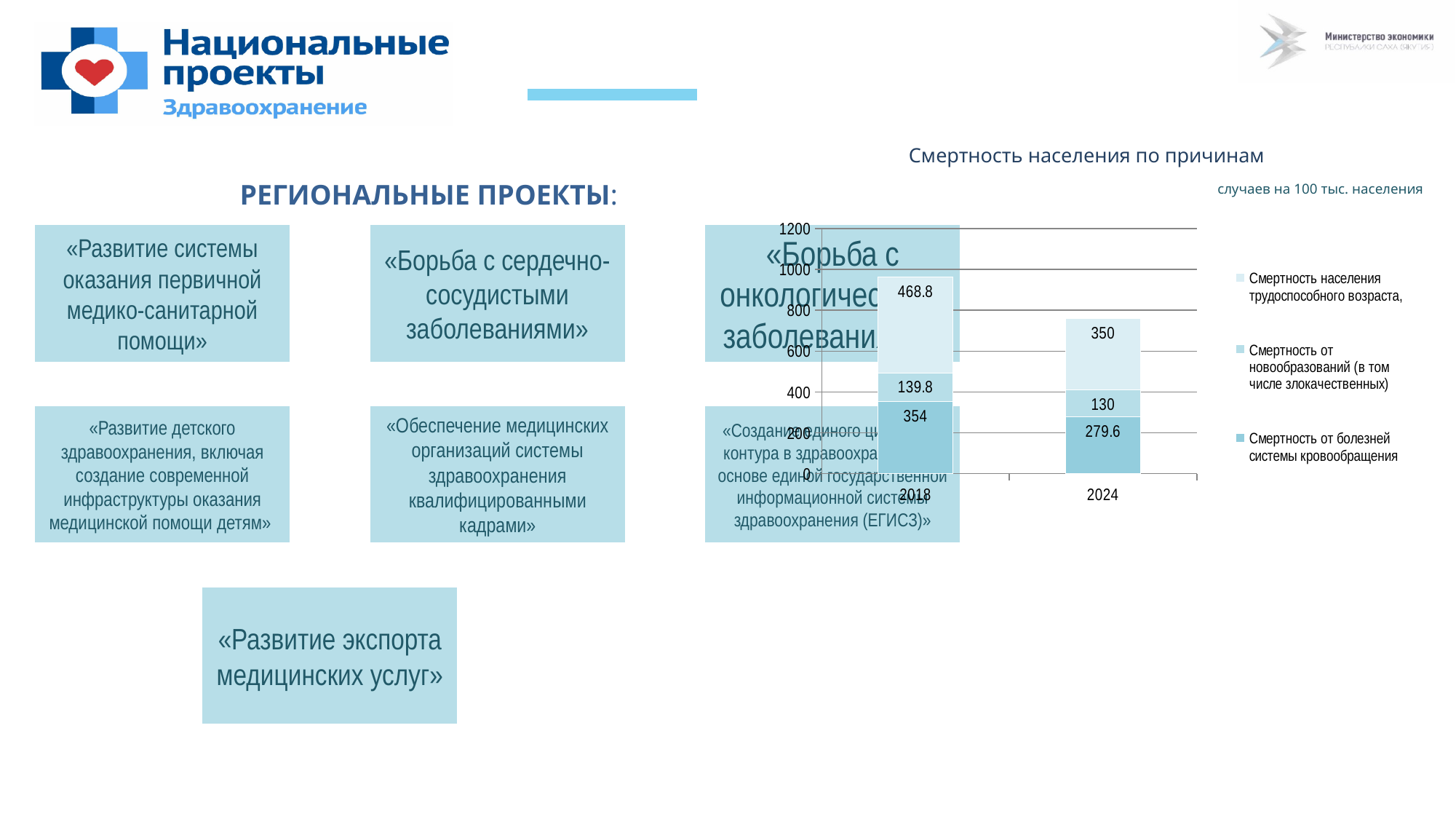
What is the title of the chart? Смертность населения по причинам What is the value for 'Смертность от болезней системы кровообращения' in 2024? 279.6 How many categories are shown on the x axis? 2 What is the value for 'Смертность от новообразований' in 2024? 130 Which year has the larger value for 'Смертность от новообразований', 2018 or 2024? 2018 How many series does the legend list? 3 What is the difference between the 2018 and 2024 values for 'Смертность населения трудоспособного возраста'? 118.8 What is the total of the stacked bar for 2018? 962.6 What is the total of the stacked bar for 2024? 759.6 What is the value for 'Смертность населения трудоспособного возраста' in 2018? 468.8 What is the value for 'Смертность от болезней системы кровообращения' in 2018? 354 What kind of chart is shown? Stacked bar chart